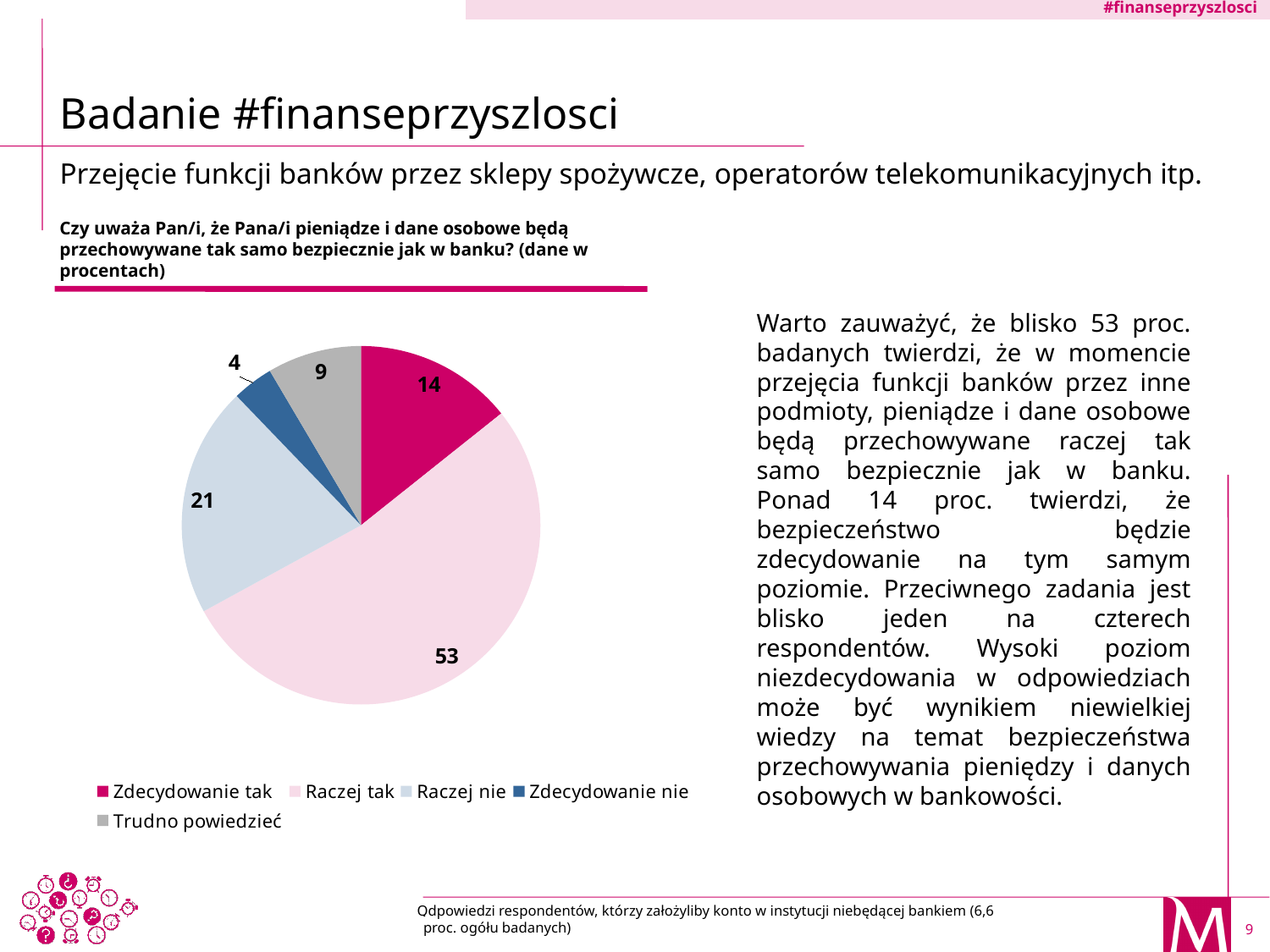
What is the value for "Raczej tak" in the pie chart? 53 What is the value for "Trudno powiedzieć" in the pie chart? 9 What is the value for "Zdecydowanie nie" in the pie chart? 4 What is the value for "Raczej nie" in the pie chart? 21 What is the difference between the values for "Raczej tak" and "Raczej nie"? 32 Which legend entry is shown in dark blue? Zdecydowanie nie What is the value for "Zdecydowanie tak" in the pie chart? 14 Which category has the largest slice in the pie chart? Raczej tak Which category has the smallest slice in the pie chart? Zdecydowanie nie How many categories does the pie chart have? 5 Which is larger, the value for "Zdecydowanie tak" or the value for "Trudno powiedzieć"? Zdecydowanie tak What kind of chart is shown on the slide? pie chart